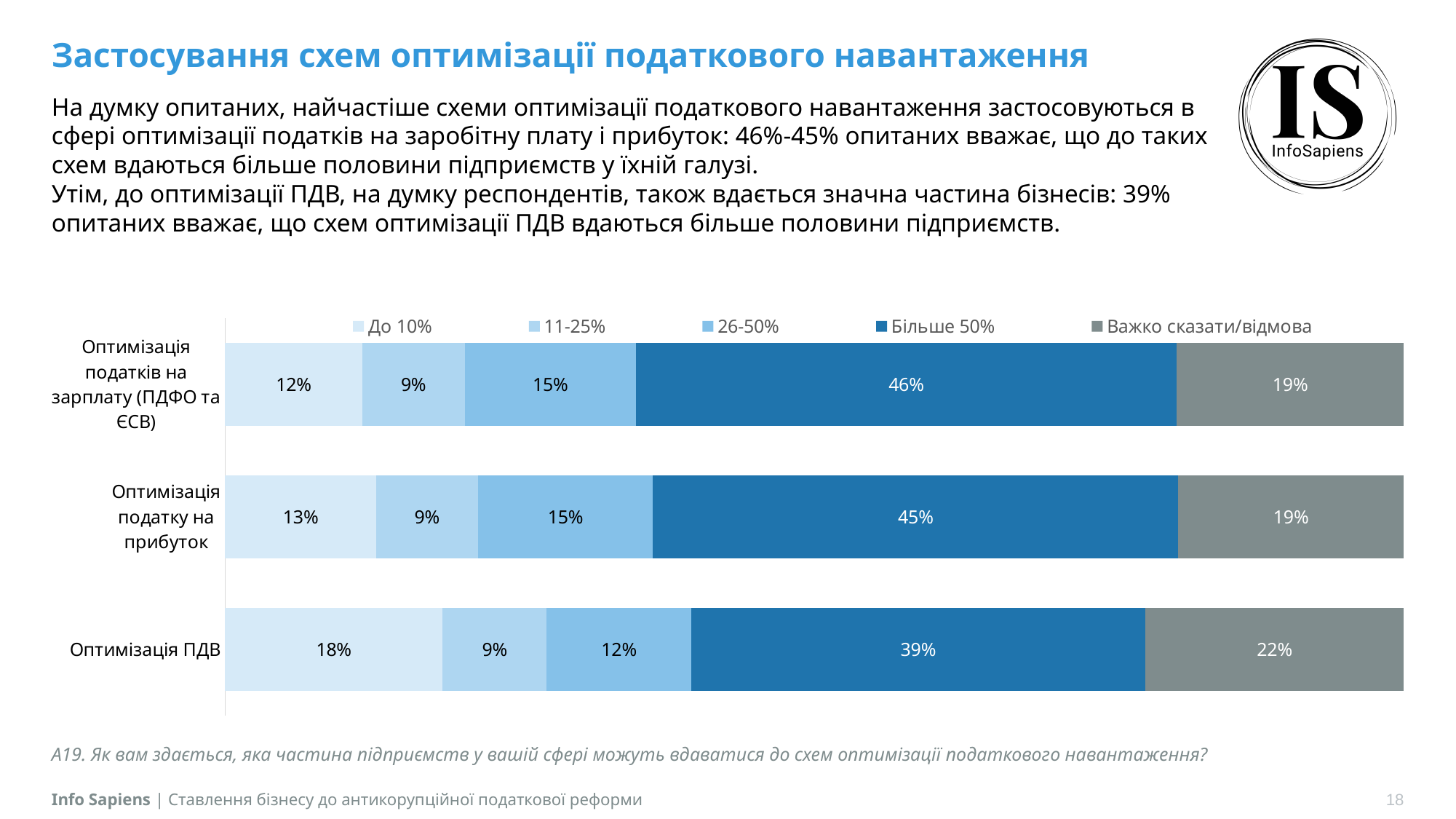
What is the value of the "Більше 50%" segment for "Оптимізація ПДВ"? 39% What is the value of the "11-25%" segment for "Оптимізація податку на прибуток"? 9% What is the value of the "До 10%" segment for "Оптимізація податків на зарплату (ПДФО та ЄСВ)"? 12% How many categories (bars) are shown in the chart? 3 How many series does the legend list? 5 What is the value of the "Важко сказати/відмова" segment for "Оптимізація ПДВ"? 22% What is the difference between the "Більше 50%" values for "Оптимізація податків на зарплату (ПДФО та ЄСВ)" and "Оптимізація ПДВ"? 7 percentage points Which has the larger "До 10%" value: "Оптимізація ПДВ" or "Оптимізація податку на прибуток"? Оптимізація ПДВ Which category has the highest value for the "Більше 50%" series? Оптимізація податків на зарплату (ПДФО та ЄСВ) What kind of chart is shown on the slide? Stacked bar chart What is the total of the stacked bar for "Оптимізація ПДВ"? 100% Which category has the lowest value for the "Більше 50%" series? Оптимізація ПДВ